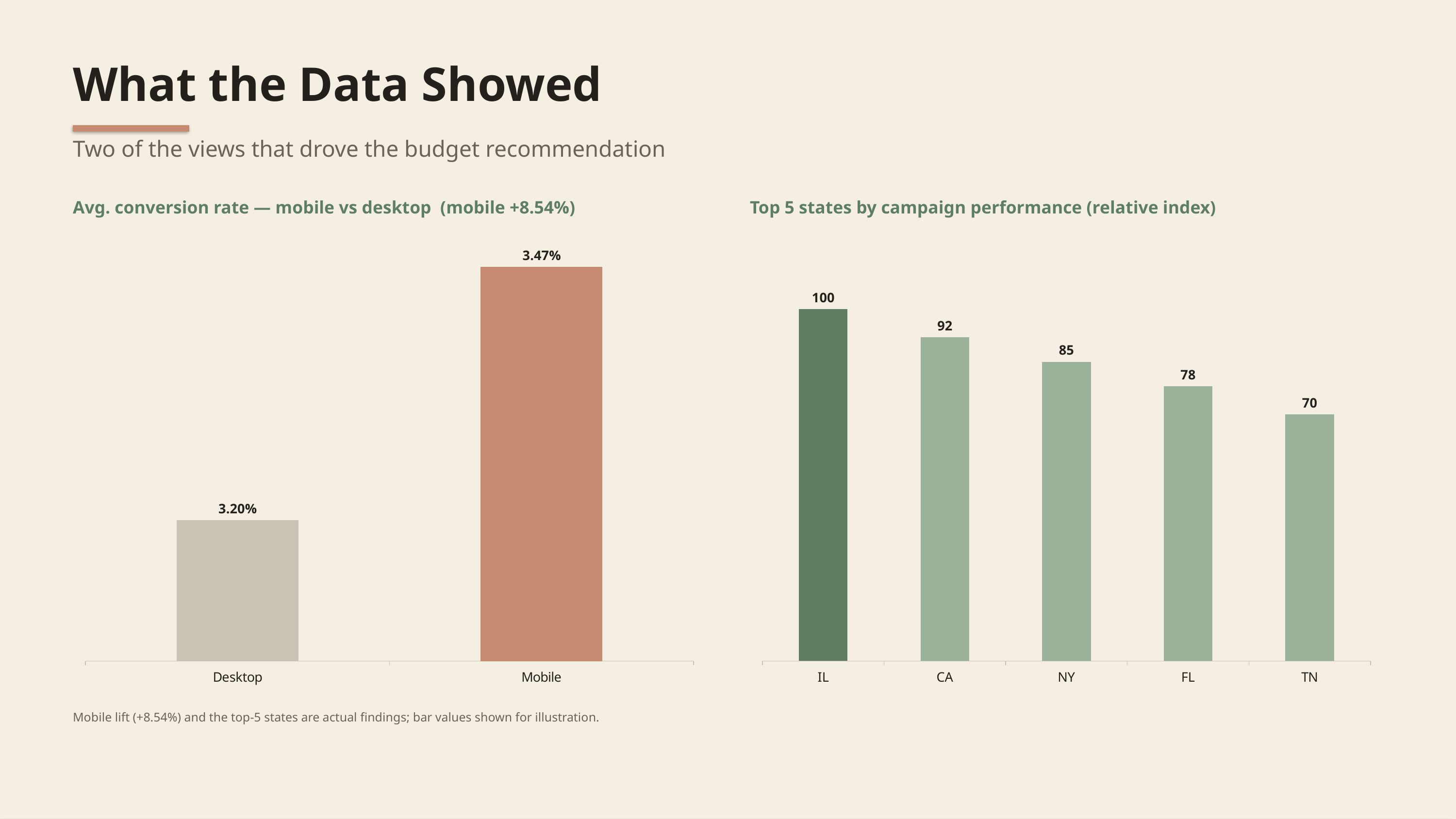
In the right chart (Top 5 states by campaign performance), which state has the lowest value? TN In the right chart (Top 5 states by campaign performance), what is the difference between the values for CA and FL? 14 In the left chart (Avg. conversion rate — mobile vs desktop), what is the value for Mobile? 3.47% In the left chart (Avg. conversion rate — mobile vs desktop), how many categories are plotted? 2 In the left chart (Avg. conversion rate — mobile vs desktop), what is the value for Desktop? 3.20% In the right chart (Top 5 states by campaign performance), do the values rise or fall from IL to TN along the x axis? fall In the left chart (Avg. conversion rate — mobile vs desktop), which category has the higher conversion rate, Desktop or Mobile? Mobile In the right chart (Top 5 states by campaign performance), what is the value for TN? 70 In the right chart (Top 5 states by campaign performance), how many states are plotted? 5 In the right chart (Top 5 states by campaign performance), which state has the highest value? IL What kind of chart is the right chart (Top 5 states by campaign performance)? bar chart In the right chart (Top 5 states by campaign performance), what is the value for NY? 85